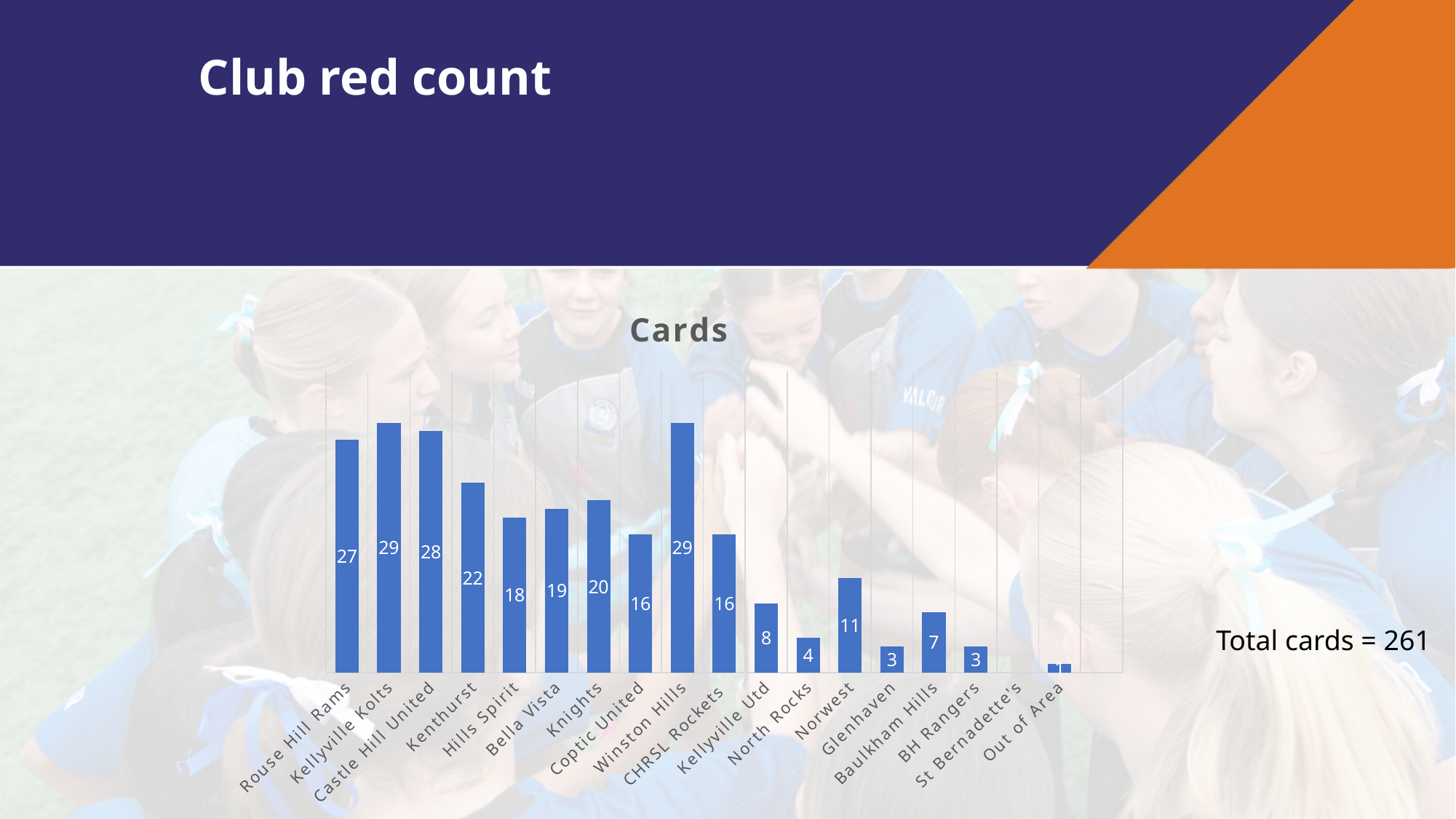
What is the difference between the values for Winston Hills and CHRSL Rockets? 13 What is the difference between the values for Castle Hill United and Hills Spirit? 10 What is the value for Glenhaven? 3 What is the value for Baulkham Hills? 7 Which has a larger value, Bella Vista or Knights? Knights What is the value for Rouse Hill Rams? 27 What kind of chart is shown on the slide? bar chart What is the value for Norwest? 11 How many categories are shown on the x axis of the chart? 18 What is the title of the chart? Cards What is the value for Kenthurst? 22 Which has a larger value, Kellyville Utd or North Rocks? Kellyville Utd